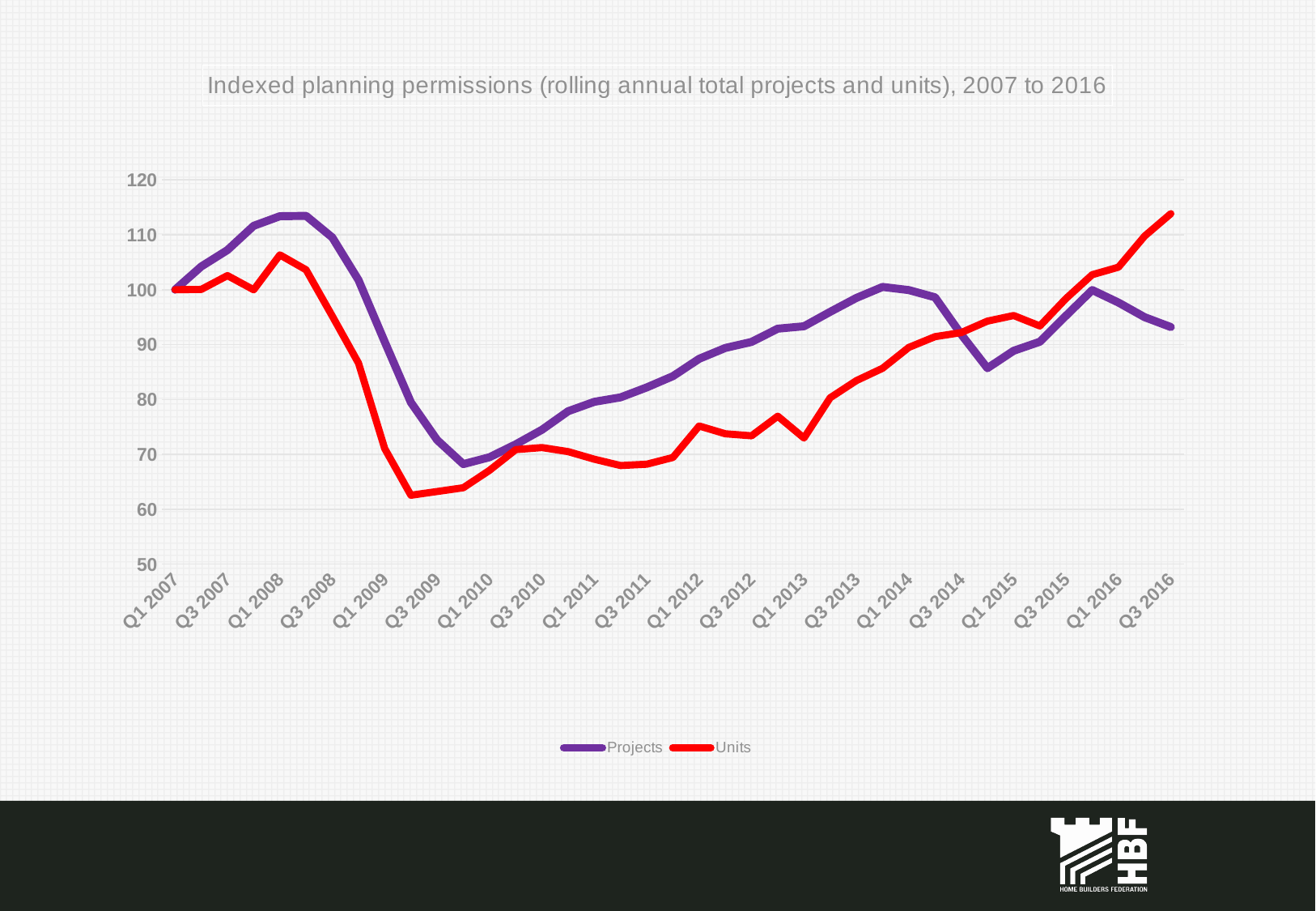
How many quarter labels are shown on the x axis? 20 At Q3 2013, which series has the higher value, Projects or Units? Projects Is the value for Projects at Q3 2016 greater or less than 100? less Which colour is used for the Units series? red At Q3 2016, which series has the higher value, Projects or Units? Units How many series does the legend list? 2 Is the value for Units at Q3 2016 greater or less than 110? greater What kind of chart is shown on the slide? line chart Is the value for Units at Q3 2009 greater or less than 70? less What is the title of the chart? Indexed planning permissions (rolling annual total projects and units), 2007 to 2016